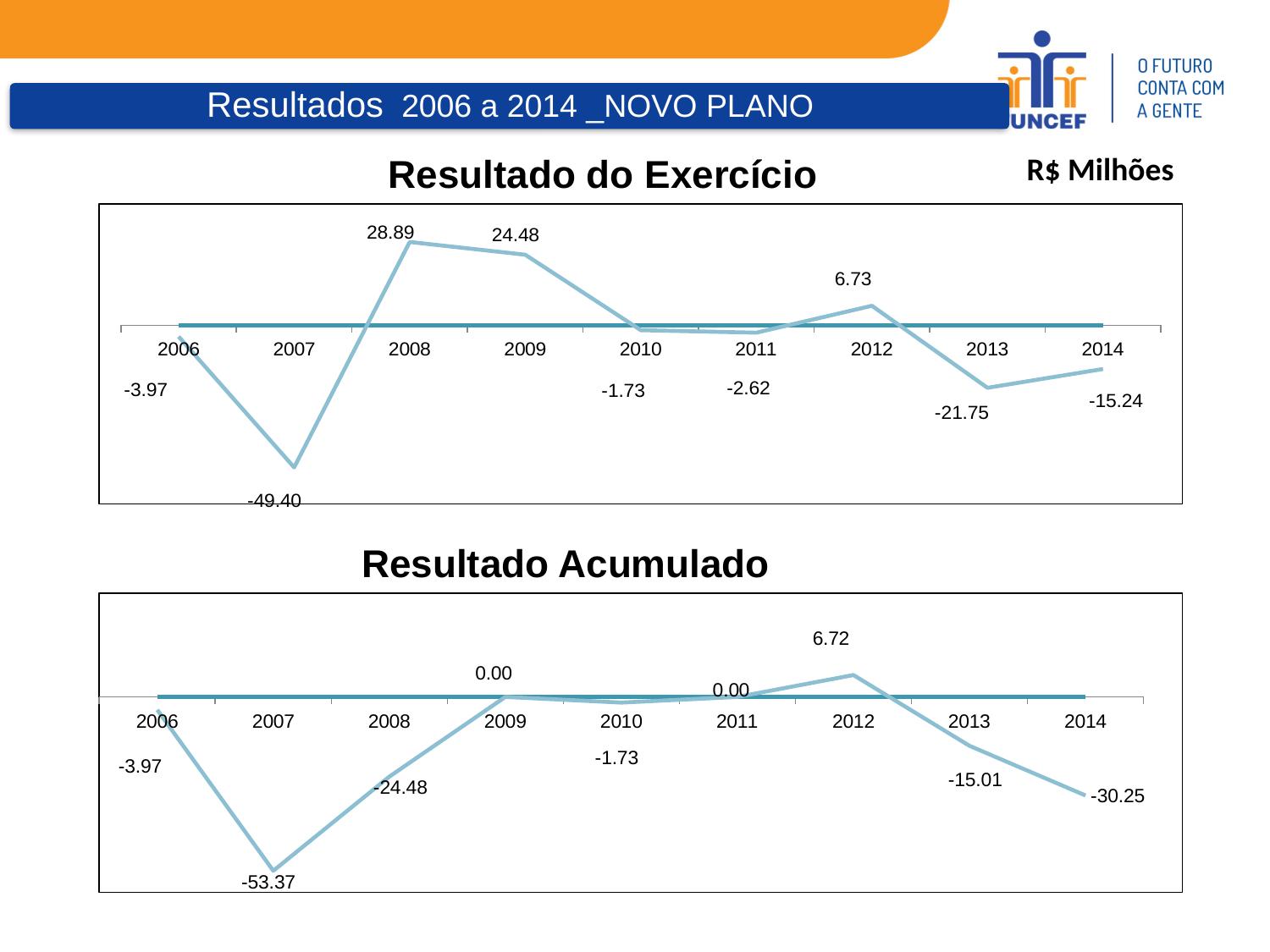
In the 'Resultado do Exercício' chart, which year has the highest value? 2008 In the 'Resultado Acumulado' chart, which year has the lowest value? 2007 In the 'Resultado Acumulado' chart, which year has the highest value? 2012 In the 'Resultado do Exercício' chart, how many years are plotted? 9 In the 'Resultado Acumulado' chart, is the value for 2012 larger or the value for 2013? 2012 What kind of chart is 'Resultado Acumulado'? Line chart In the 'Resultado do Exercício' chart, what is the value for 2008? 28.89 In the 'Resultado do Exercício' chart, which year has the lowest value? 2007 In the 'Resultado do Exercício' chart, what is the value for 2013? -21.75 In the 'Resultado Acumulado' chart, what is the value for 2014? -30.25 In the 'Resultado do Exercício' chart, what is the difference between the 2008 and 2009 values? 4.41 In the 'Resultado Acumulado' chart, do the values rise or fall from 2012 to 2014? Fall